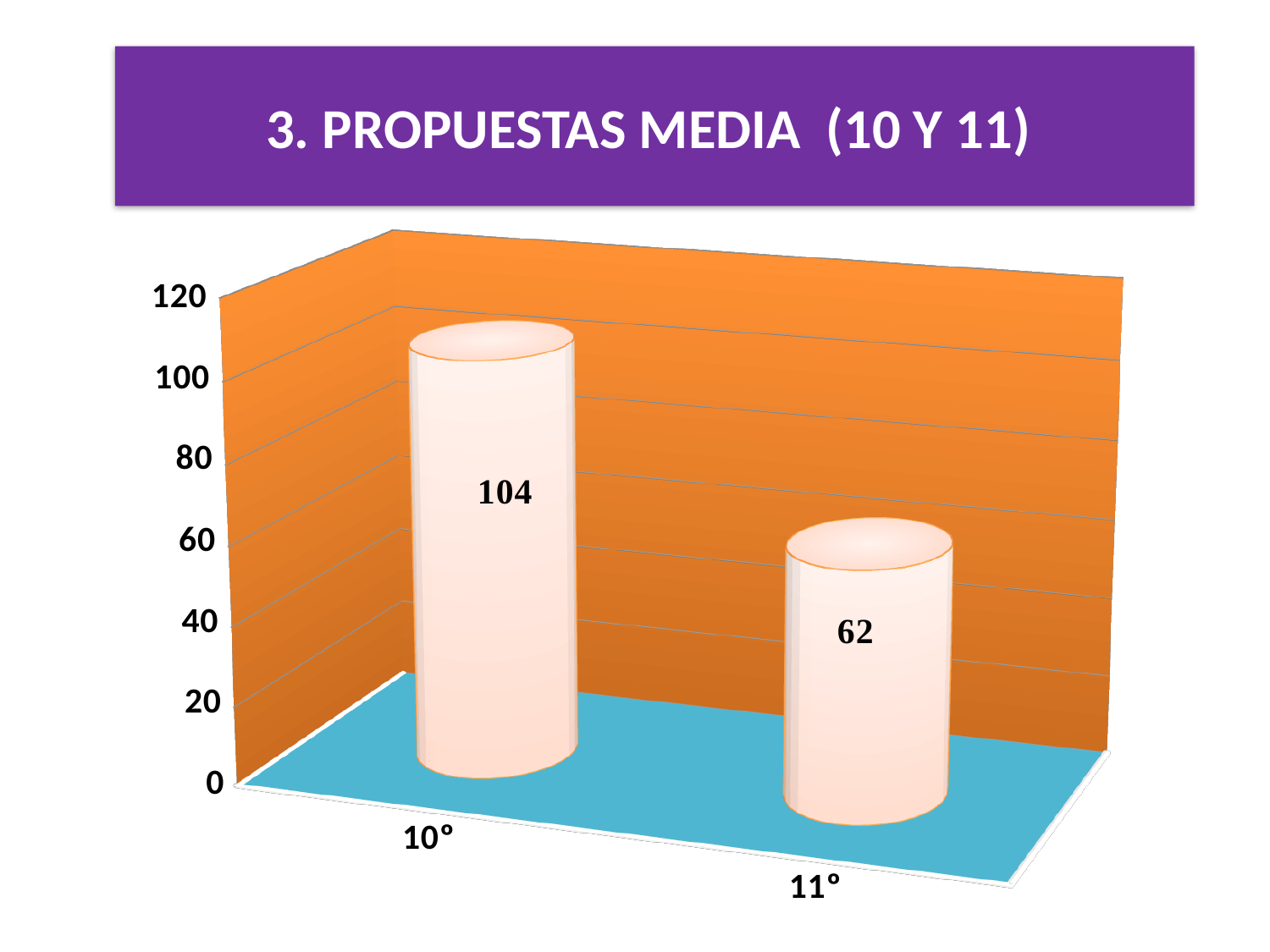
Which category has the lowest value? 11° How many categories are shown on the x axis? 2 Which category has the highest value? 10° What kind of chart is shown on the slide? bar chart Is the value for 11° greater or less than 80? less Is the value for 10° greater or less than 100? greater What is the value for 10°? 104 What is the title of the slide? 3. PROPUESTAS MEDIA (10 Y 11) Which is larger, the value for 10° or the value for 11°? 10° What is the value for 11°? 62 What is the difference between the values for 10° and 11°? 42 Do the values rise or fall from 10° to 11°? fall